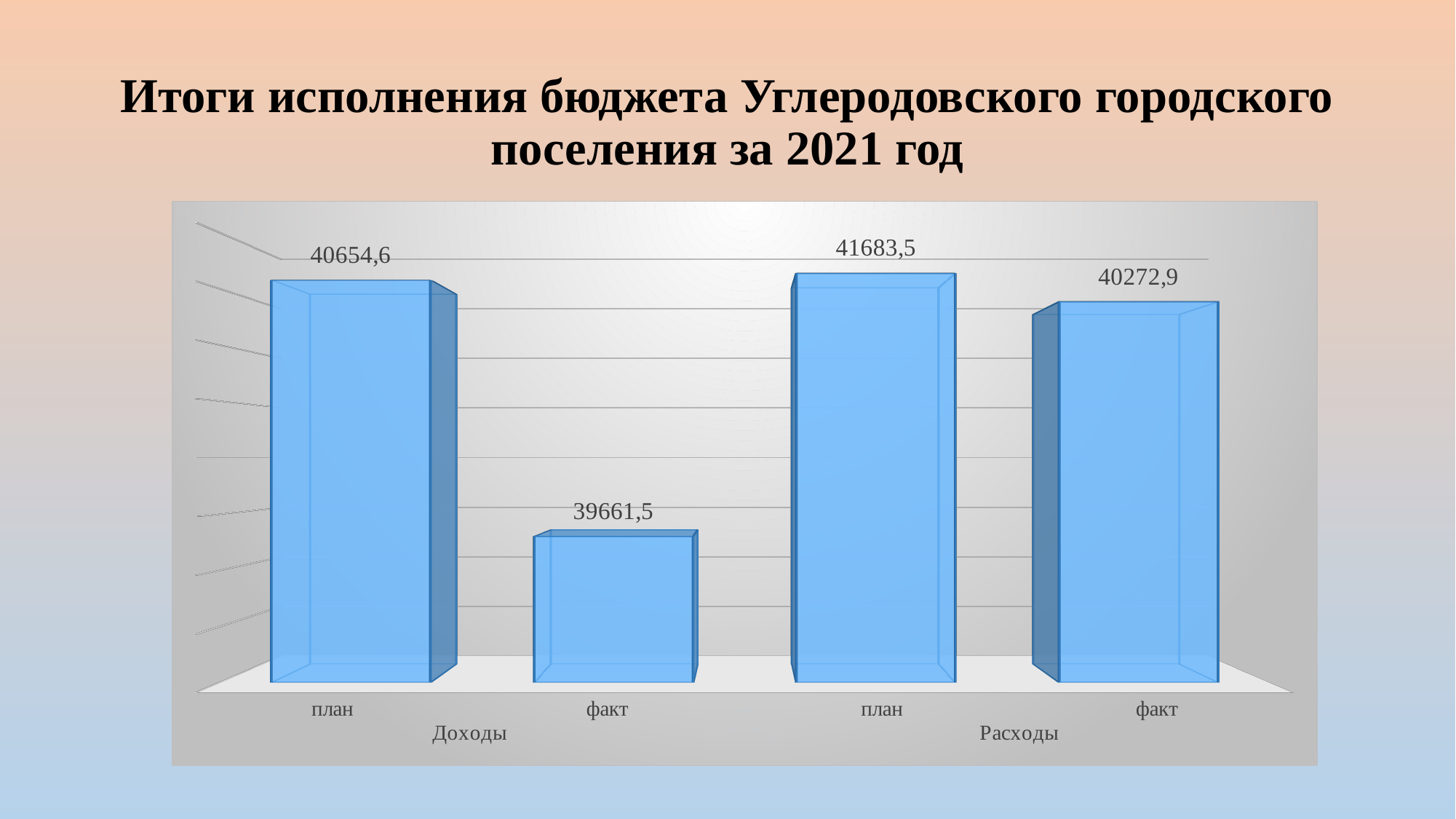
What kind of chart is shown on the slide? Bar chart Which bar has the lowest value? Доходы факт How many bars are plotted on the chart? 4 What is the title of the slide? Итоги исполнения бюджета Углеродовского городского поселения за 2021 год What is the value of the план bar for Расходы? 41683,5 What is the difference between the план and факт values for Доходы? 993,1 What is the value of the план bar for Доходы? 40654,6 What is the value of the факт bar for Расходы? 40272,9 What is the value of the факт bar for Доходы? 39661,5 Which bar has the highest value? Расходы план Which is larger, the факт value for Доходы or the факт value for Расходы? Расходы факт What is the difference between the план and факт values for Расходы? 1410,6